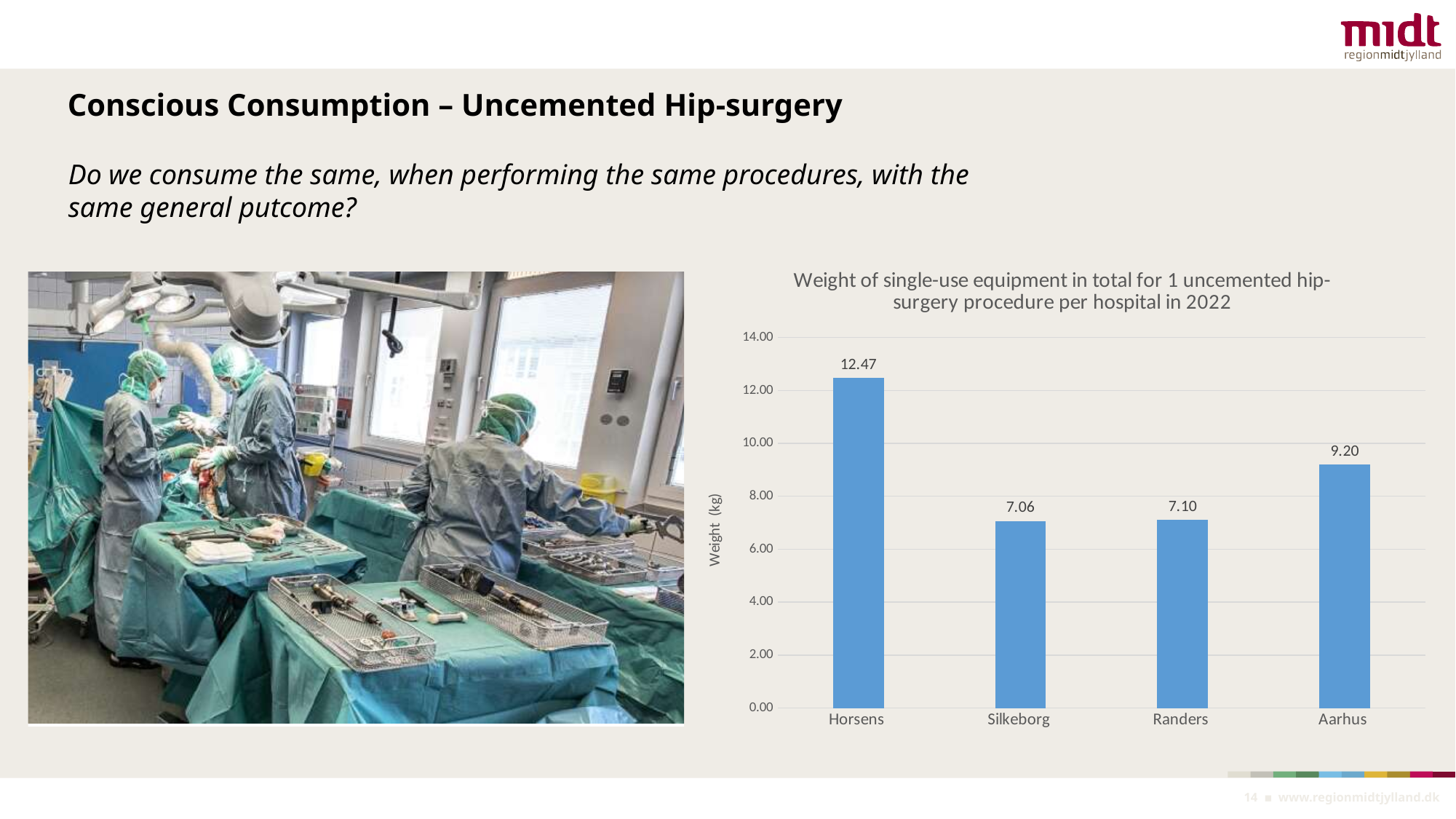
What is the weight of single-use equipment for Randers? 7.10 What is the difference in weight between Horsens and Aarhus? 3.27 What is the weight of single-use equipment for Silkeborg? 7.06 Is the value for Aarhus greater or less than 10.00? less How many hospitals are shown in the chart? 4 What kind of chart is shown on the slide? bar chart Which hospital has the lowest weight of single-use equipment? Silkeborg Which hospital has a larger weight of single-use equipment, Aarhus or Silkeborg? Aarhus What is the label of the vertical axis of the chart? Weight (kg) Which hospital has the highest weight of single-use equipment? Horsens What is the weight of single-use equipment for Horsens? 12.47 What is the weight of single-use equipment for Aarhus? 9.20